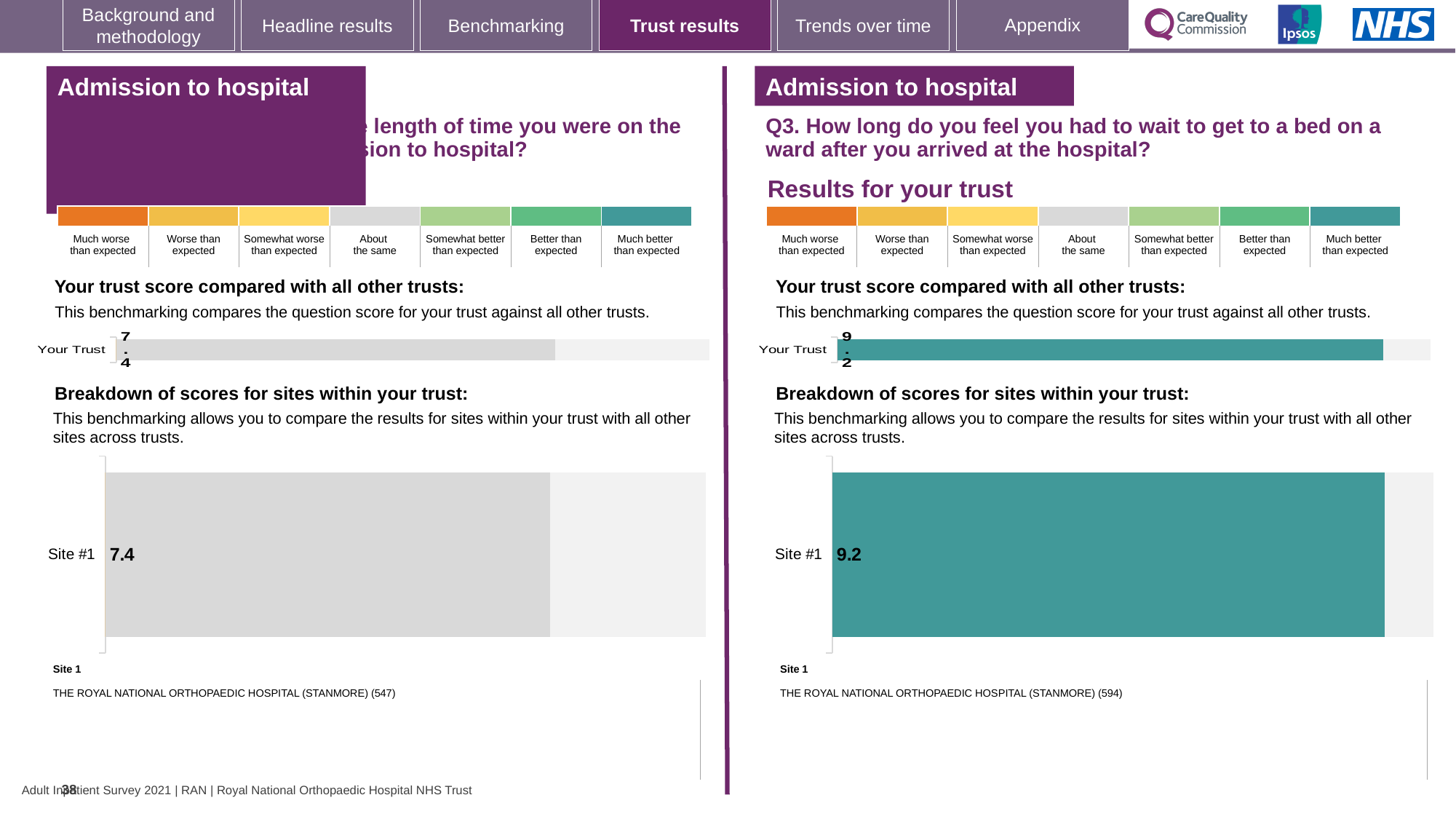
How many sites are plotted in the right-hand (Q3) 'Breakdown of scores for sites within your trust' chart? 1 On the left half of the slide, what is the score shown for Your Trust in the 'Your trust score compared with all other trusts' chart? 7.4 On the right half of the slide (Q3), what is the score shown for Your Trust in the 'Your trust score compared with all other trusts' chart? 9.2 Is the Site #1 score in the left-hand breakdown chart equal to the Your Trust score in the left-hand trust chart? Yes Which is larger: the Site #1 score in the left-hand breakdown chart or the Site #1 score in the right-hand (Q3) breakdown chart? The right-hand (Q3) Site #1 score What colour is the Site #1 bar in the right-hand (Q3) breakdown chart? Teal On the right half of the slide (Q3), what score is shown for Site #1 in the 'Breakdown of scores for sites within your trust' chart? 9.2 What kind of chart is used to show the Site #1 score in the right-hand (Q3) 'Breakdown of scores for sites within your trust' section? Bar chart Which site name is listed under Site 1 for the right-hand (Q3) breakdown chart? THE ROYAL NATIONAL ORTHOPAEDIC HOSPITAL (STANMORE) (594) How many sites are plotted in the left-hand 'Breakdown of scores for sites within your trust' chart? 1 What is the difference between the Your Trust score on the right half of the slide (Q3) and the Your Trust score on the left half of the slide? 1.8 On the left half of the slide, what score is shown for Site #1 in the 'Breakdown of scores for sites within your trust' chart? 7.4